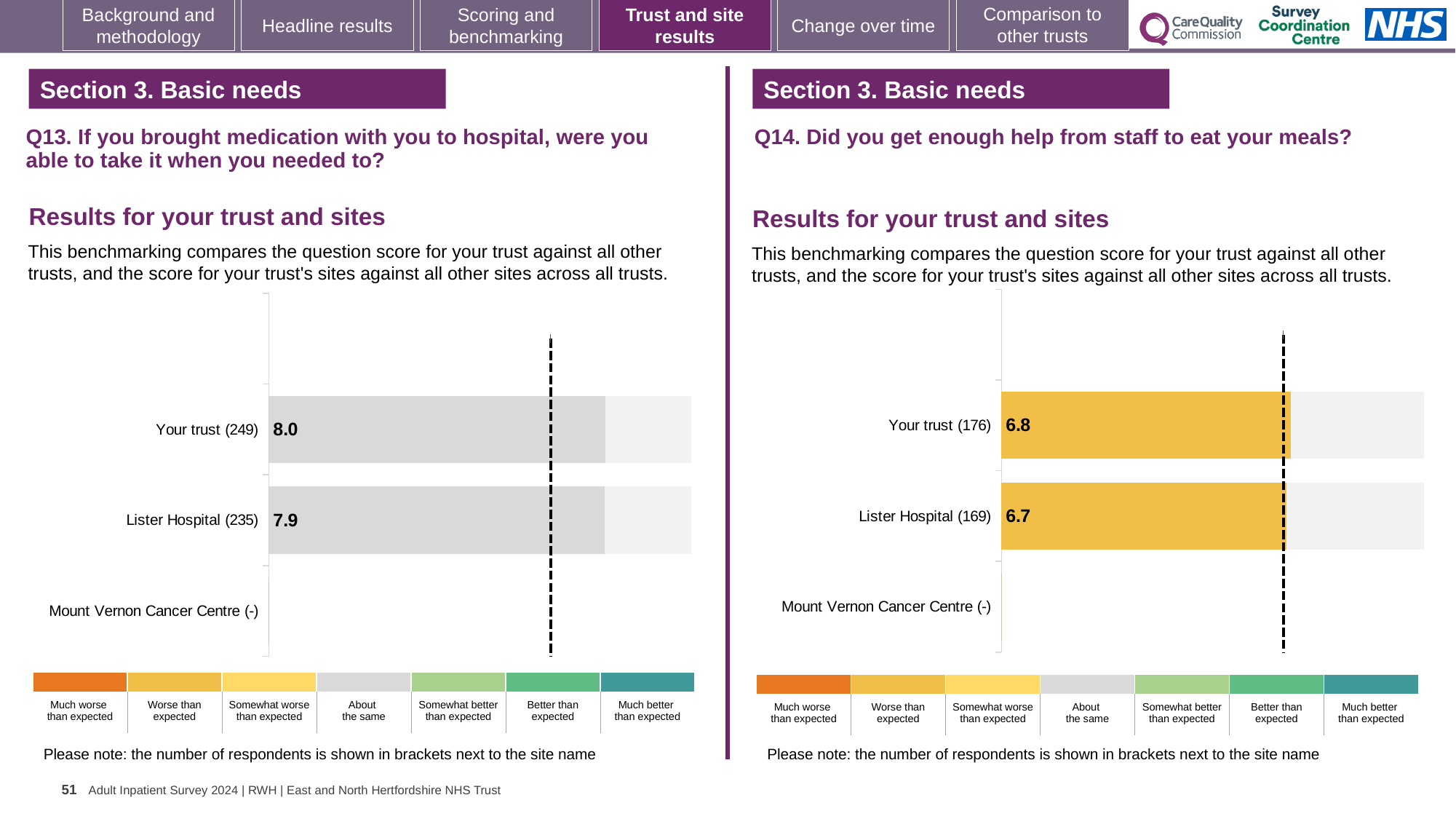
On the Q13 chart (left), what is the score for Lister Hospital? 7.9 On the Q13 chart (left), what is the difference between the Your trust score and the Lister Hospital score? 0.1 How many site/trust categories are listed on the Q14 chart (right)? 3 On the Q14 chart (right), which has the higher score, Your trust or Lister Hospital? Your trust On the Q13 chart (left), how many respondents are shown for Your trust? 249 On the Q14 chart (right), what is the score for Your trust? 6.8 What type of chart is used on the Q13 chart (left)? Bar chart On the Q13 chart (left), which site has no score shown? Mount Vernon Cancer Centre On the Q14 chart (right), which benchmark category does the colour of the Your trust bar correspond to? Worse than expected On the Q13 chart (left), what is the score for Your trust? 8.0 On the Q14 chart (right), how many respondents are shown for Lister Hospital? 169 On the Q14 chart (right), what is the score for Lister Hospital? 6.7